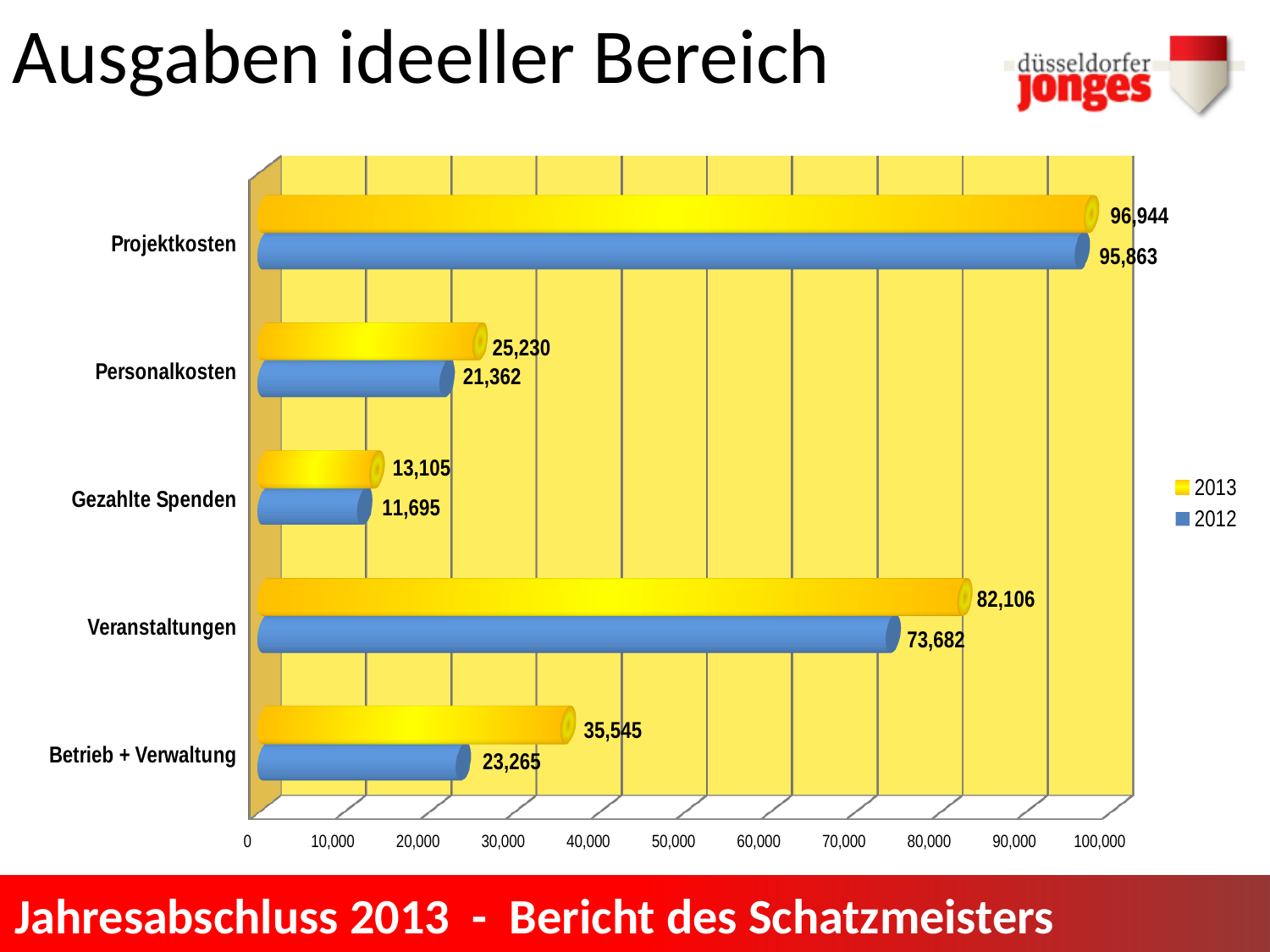
How many series does the legend list? 2 What is the difference between the 2013 and 2012 values for Betrieb + Verwaltung? 12,280 What kind of chart is shown on the slide? Bar chart How many categories are shown on the chart? 5 Which is larger, the 2013 value for Personalkosten or the 2013 value for Betrieb + Verwaltung? Betrieb + Verwaltung Which category has the highest 2013 value? Projektkosten Which category has the lowest 2012 value? Gezahlte Spenden What is the 2012 value for Gezahlte Spenden? 11,695 What is the 2012 value for Veranstaltungen? 73,682 What is the 2013 value for Projektkosten? 96,944 What is the difference between the 2013 and 2012 values for Veranstaltungen? 8,424 What is the 2013 value for Betrieb + Verwaltung? 35,545